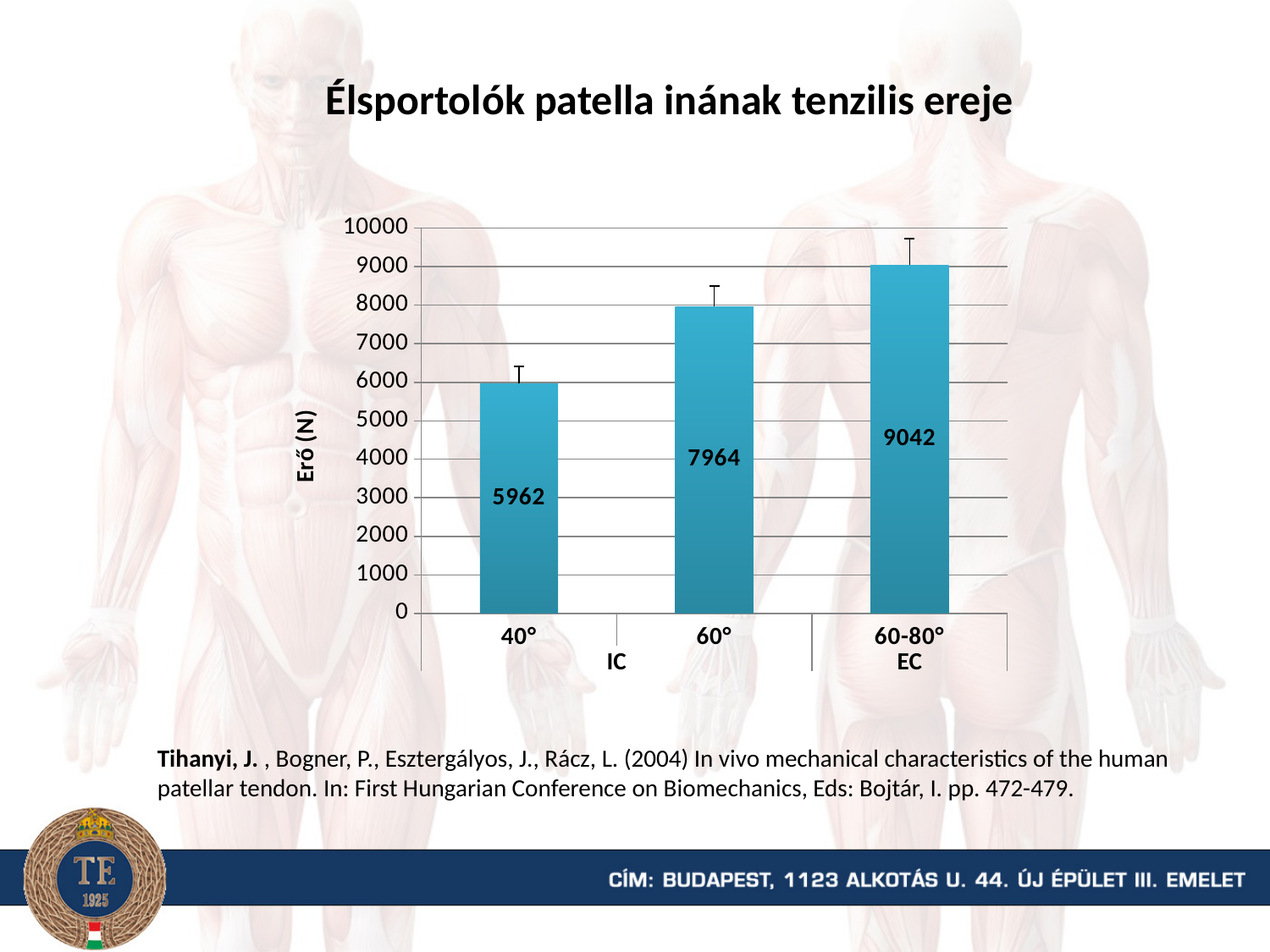
What is the value for 40°? 5962 How many bars are shown in the chart? 3 What is the difference between the values for 60-80° and 40°? 3080 What is the value for 60-80°? 9042 What is the difference between the values for 60° and 40°? 2002 What kind of chart is shown on the slide? bar chart What is the label of the vertical axis? Erő (N) What is the value for 60°? 7964 Which category has the highest value? 60-80° Which is larger, the value for 60° or the value for 40°? 60° Which category has the lowest value? 40° Is the value for 60-80° greater or less than 8000? greater